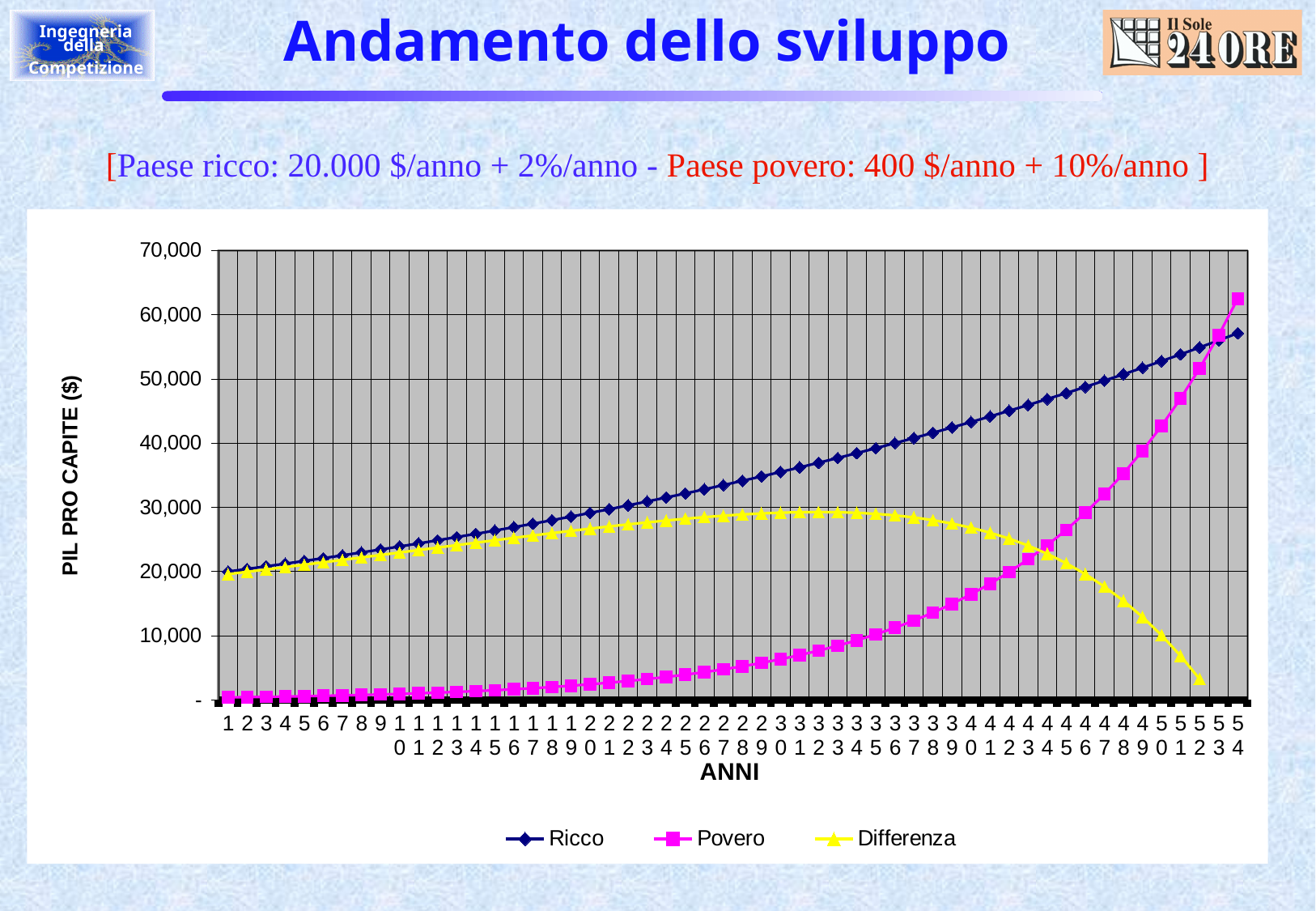
What kind of chart is shown on the slide? line chart How many series does the legend list? 3 Is the value of the Povero series in year 30 greater or less than 10,000? less Is the value of the Povero series in year 54 greater or less than 60,000? greater What is the title of the vertical axis? PIL PRO CAPITE ($) What is the value of the Ricco series in year 1? 20,000 How many years (points) are plotted along the x axis? 54 Does the Ricco series rise or fall as the years increase along the x axis? rise Is the value of the Ricco series in year 54 greater or less than 50,000? greater In year 54, which series has the higher value, Ricco or Povero? Povero What are the three series named in the legend? Ricco, Povero, Differenza